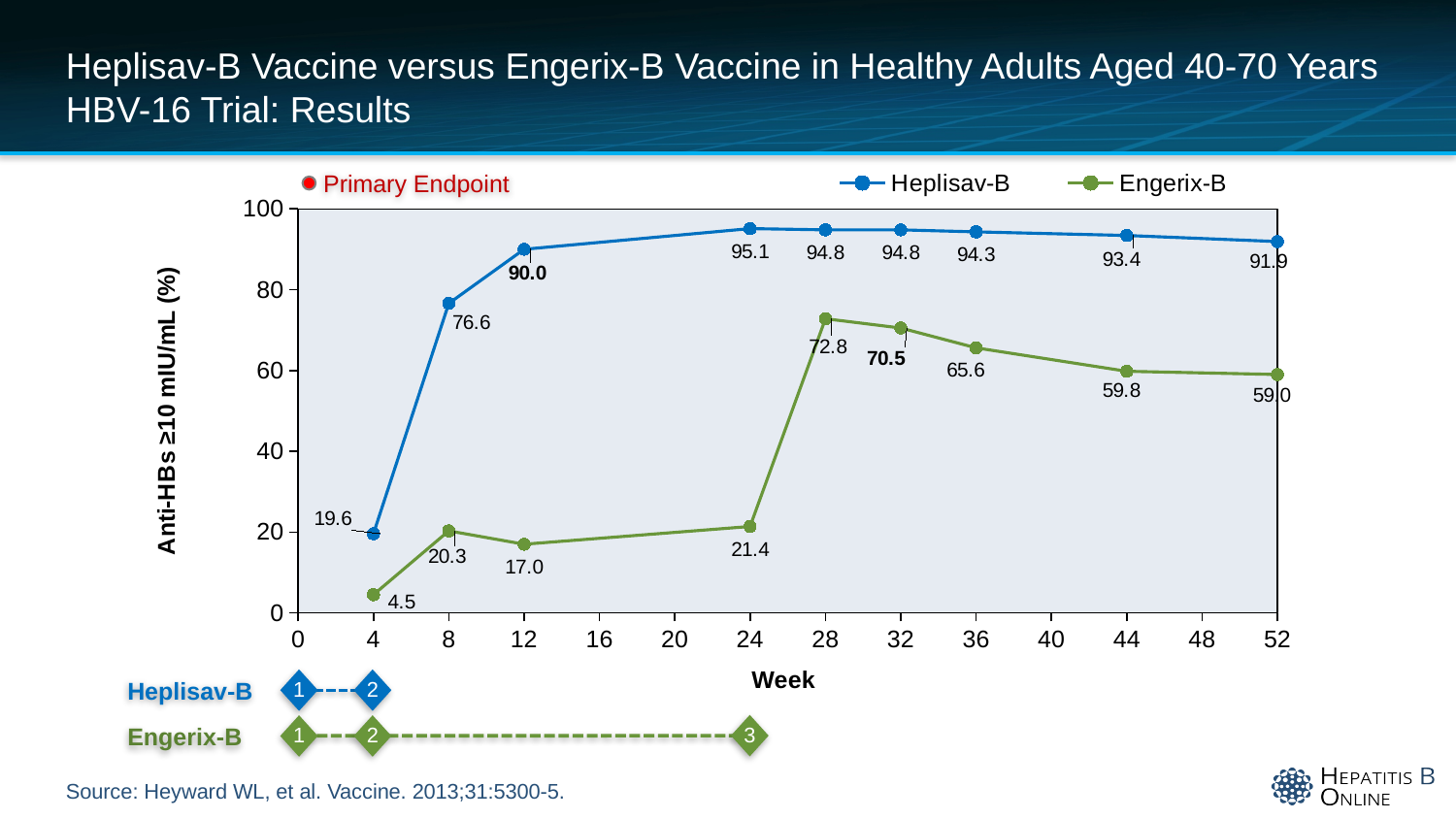
What is the Engerix-B value at week 28? 72.8 What is the difference between the Heplisav-B and Engerix-B values at week 32? 24.3 What type of chart is shown on the slide? Line chart At which week does Heplisav-B reach its highest value? Week 24 Does the Engerix-B value rise or fall from week 28 to week 52? Fall What is the Engerix-B value at week 4? 4.5 What is the Heplisav-B value at week 52? 91.9 How many series does the legend list? 2 What is the label of the y-axis? Anti-HBs ≥10 mIU/mL (%) At which week is the Engerix-B value lowest? Week 4 What is the Heplisav-B value at week 12? 90.0 Which series has the higher value at week 8, Heplisav-B or Engerix-B? Heplisav-B